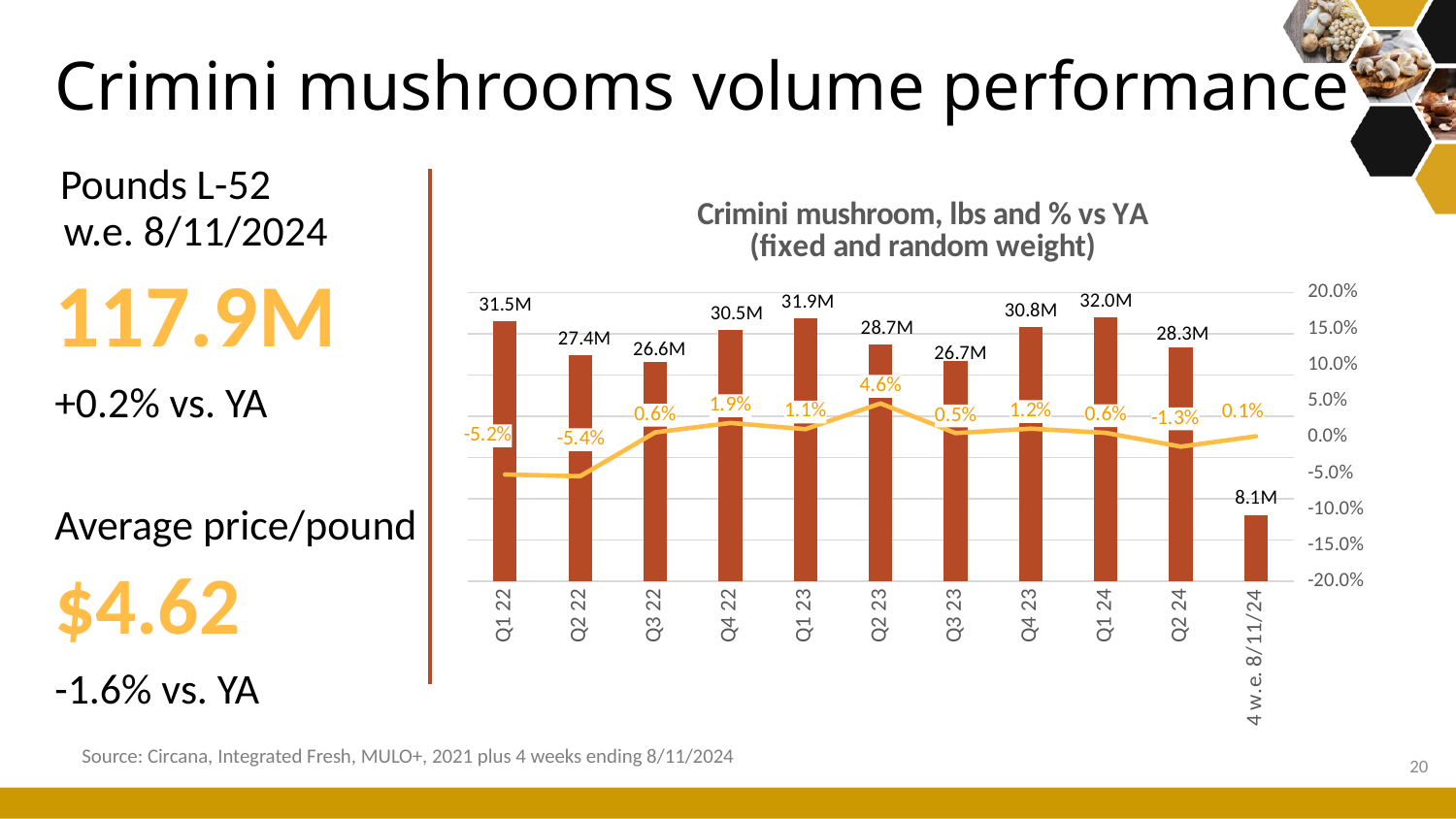
What is the title of the chart? Crimini mushroom, lbs and % vs YA (fixed and random weight) What is the difference in pounds between Q1 24 and Q2 24? 3.7M Which period has the lowest % vs YA value on the line? Q2 22 What is the % vs YA value shown for Q2 23? 4.6% What is the pounds value for the 4 w.e. 8/11/24 period? 8.1M What is the pounds value for Q1 24 in the Crimini mushroom chart? 32.0M What kind of chart is shown on the slide? Combination bar and line chart Which period has the highest % vs YA value on the line? Q2 23 How many periods are shown on the x axis of the chart? 11 Which quarter has the highest pounds value among the bars? Q1 24 What is the % vs YA value shown for Q2 24? -1.3% Which is larger, the pounds value for Q3 22 or Q4 22? Q4 22